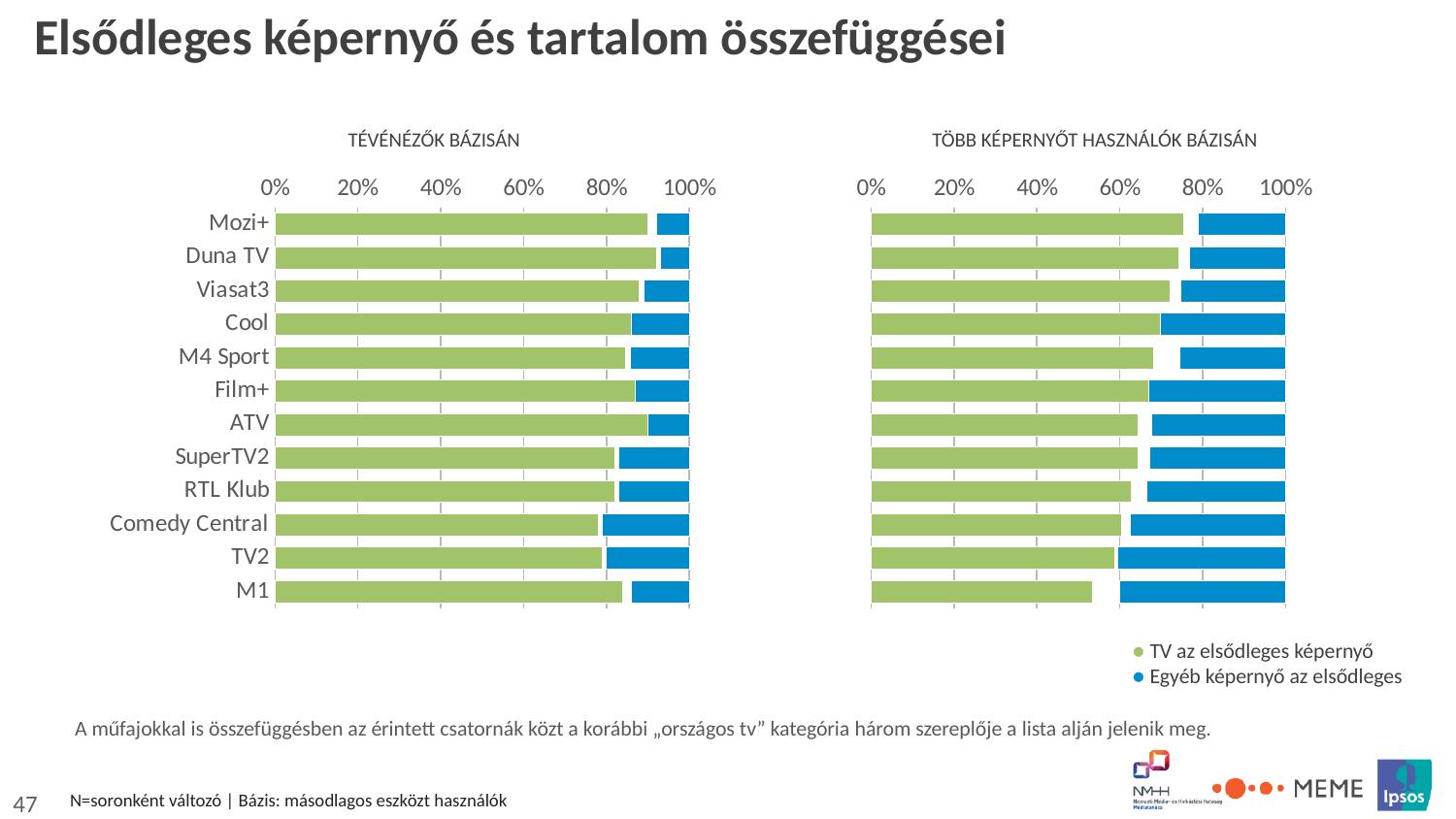
On the left chart "TÉVÉNÉZŐK BÁZISÁN", is the "TV az elsődleges képernyő" value for Mozi+ greater or less than 80%? greater On the left chart "TÉVÉNÉZŐK BÁZISÁN", which has the larger "TV az elsődleges képernyő" share, Duna TV or Comedy Central? Duna TV Which series is shown in blue in the charts? Egyéb képernyő az elsődleges On the left chart "TÉVÉNÉZŐK BÁZISÁN", is the "TV az elsődleges képernyő" value for Comedy Central greater or less than 80%? less On the right chart "TÖBB KÉPERNYŐT HASZNÁLÓK BÁZISÁN", which has the larger "TV az elsődleges képernyő" share, Mozi+ or M1? Mozi+ On the right chart "TÖBB KÉPERNYŐT HASZNÁLÓK BÁZISÁN", which channel has the lowest share for "TV az elsődleges képernyő"? M1 How many series does the legend list for the charts? 2 What kind of chart is the left chart titled "TÉVÉNÉZŐK BÁZISÁN"? Stacked bar chart On the right chart "TÖBB KÉPERNYŐT HASZNÁLÓK BÁZISÁN", is the "TV az elsődleges képernyő" value for Mozi+ greater or less than 60%? greater How many channels are listed on the left chart "TÉVÉNÉZŐK BÁZISÁN"? 12 What is the title of the right chart? TÖBB KÉPERNYŐT HASZNÁLÓK BÁZISÁN